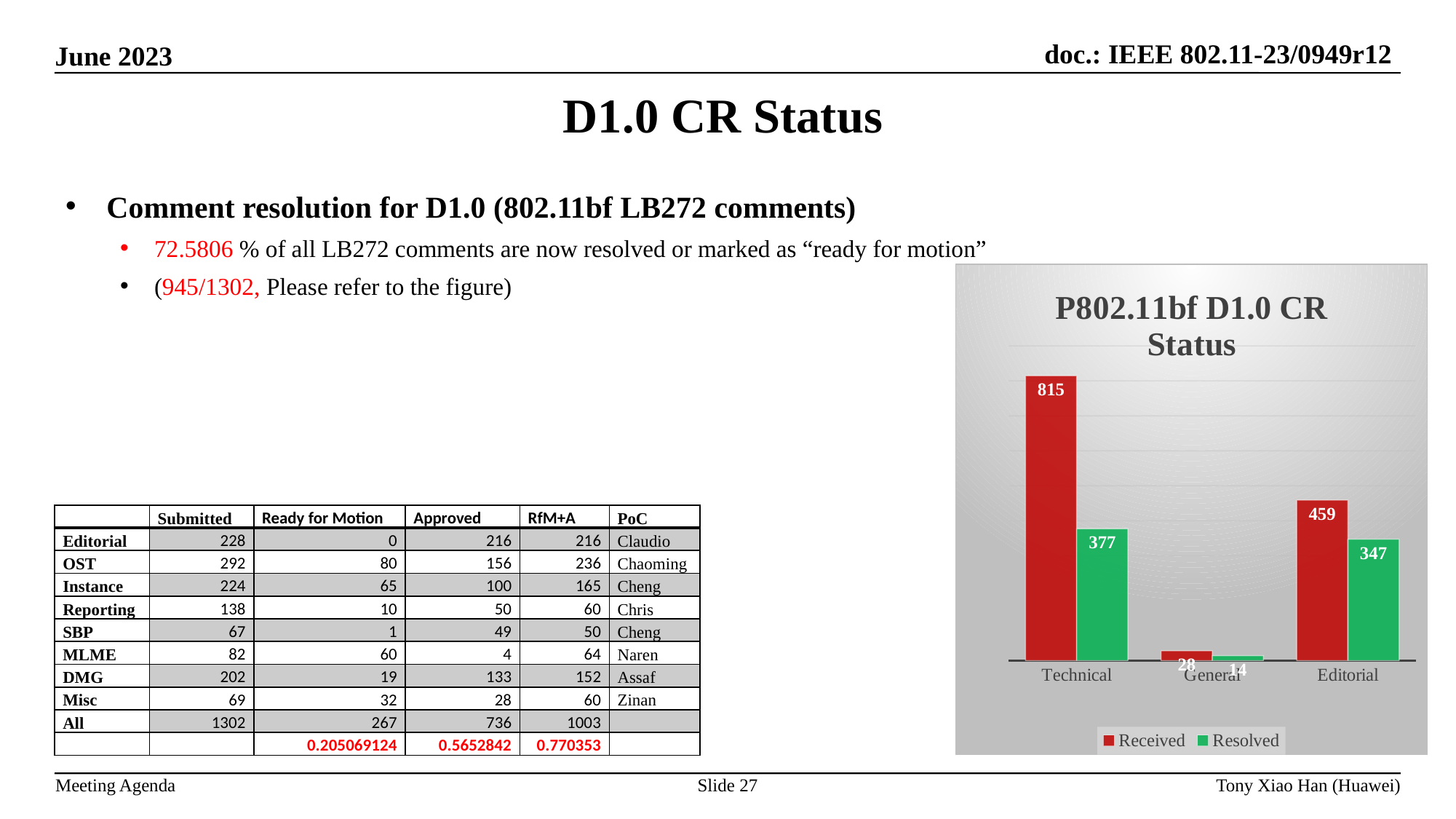
Which category has the lowest Resolved value? General What is the Received value for General? 28 What is the difference between Received and Resolved for Technical? 438 How many categories are shown on the x axis of the chart? 3 Which category has the highest Received value? Technical What is the Received value for Technical? 815 What type of chart is shown on the slide? bar chart What is the Resolved value for Editorial? 347 How many series does the chart legend list? 2 Is the Resolved value for Editorial larger than the Resolved value for Technical? No Which series is shown in red in the chart? Received What is the title of the chart? P802.11bf D1.0 CR Status